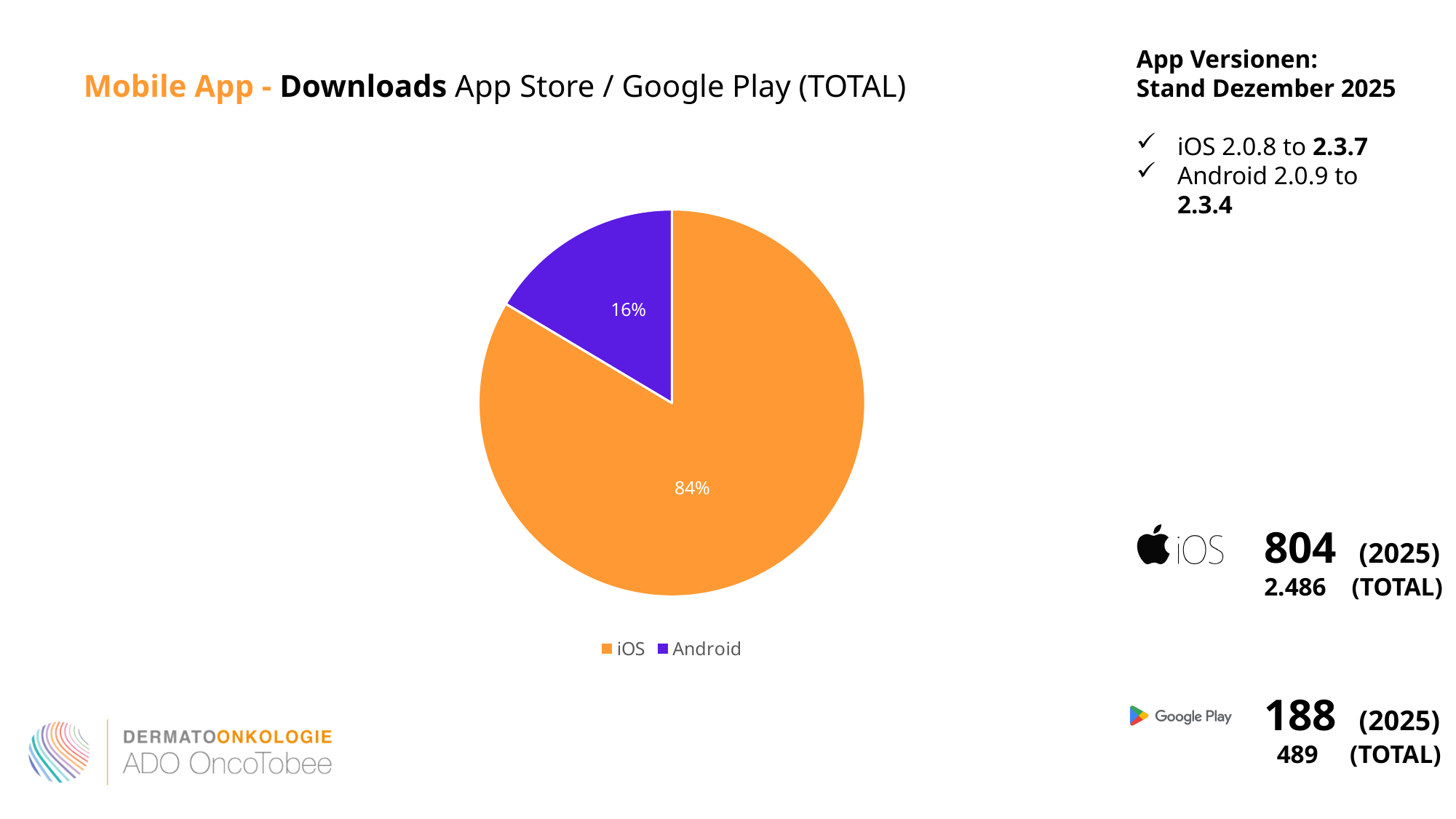
Which slice of the pie is the largest? iOS What share of the pie does iOS have? 84% What is the difference in percentage points between the iOS share and the Android share? 68 What share of the pie does Android have? 16% What kind of chart is shown on the slide? pie chart Which is larger, the iOS share or the Android share? iOS Which slice of the pie is the smallest? Android What colour is the Android slice in the pie chart? purple What colour is the iOS slice in the pie chart? orange How many entries does the legend list? 2 How many slices does the pie chart have? 2 Is the iOS share greater or less than 50%? greater